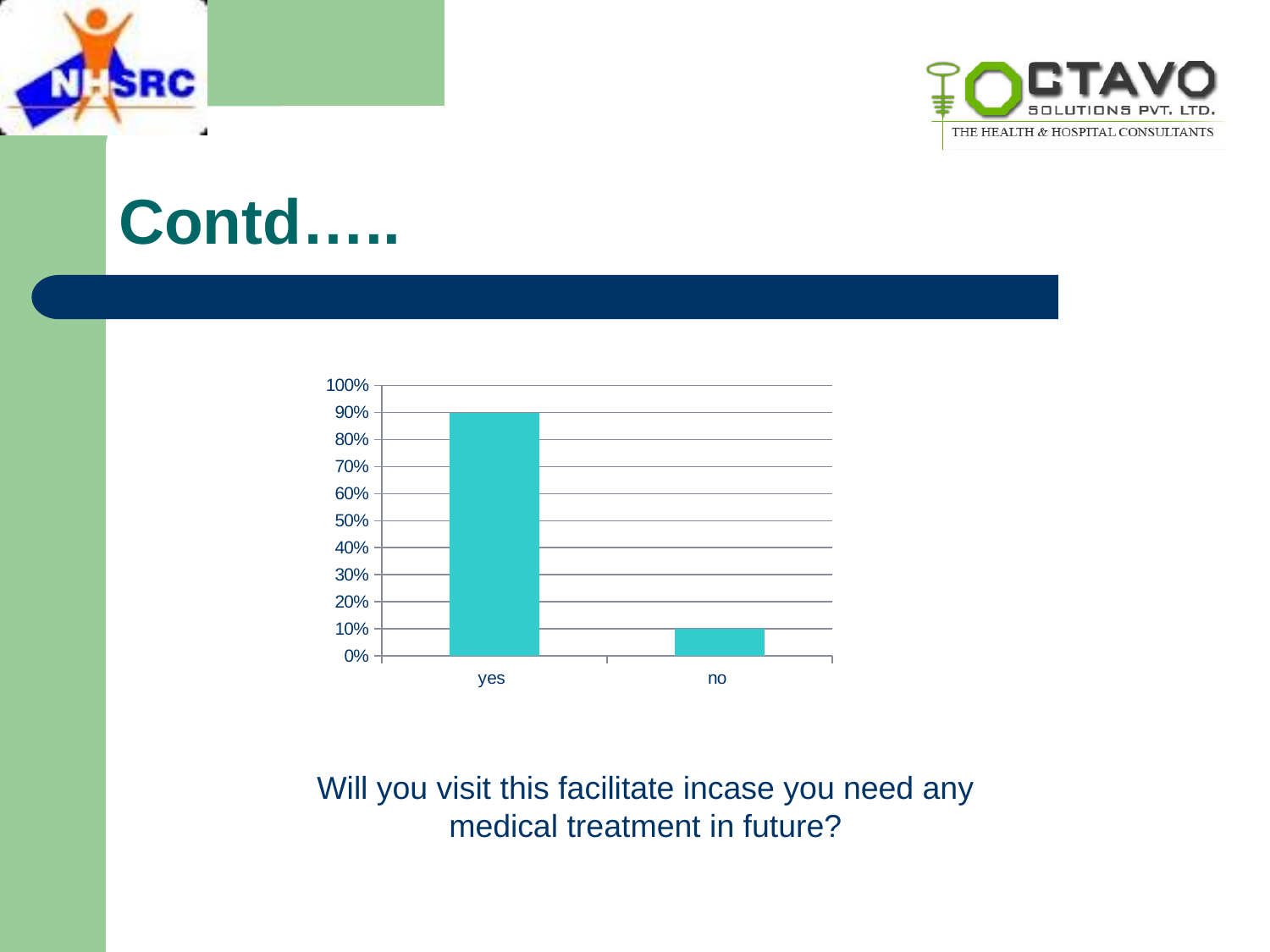
What is the highest value shown on the y axis of the chart? 100% Which is larger, the value for "yes" or the value for "no"? yes What question does the caption below the chart say the chart answers? Will you visit this facilitate incase you need any medical treatment in future? Which category has the highest value in the chart? yes Which category has the lowest value in the chart? no What is the value for "yes" in the chart? 90% Is the value for "no" greater or less than 20%? less What is the difference between the value for "yes" and the value for "no"? 80% How many categories are shown on the x axis of the chart? 2 Is the value for "yes" greater or less than 50%? greater What kind of chart is shown on the slide? bar chart What is the value for "no" in the chart? 10%